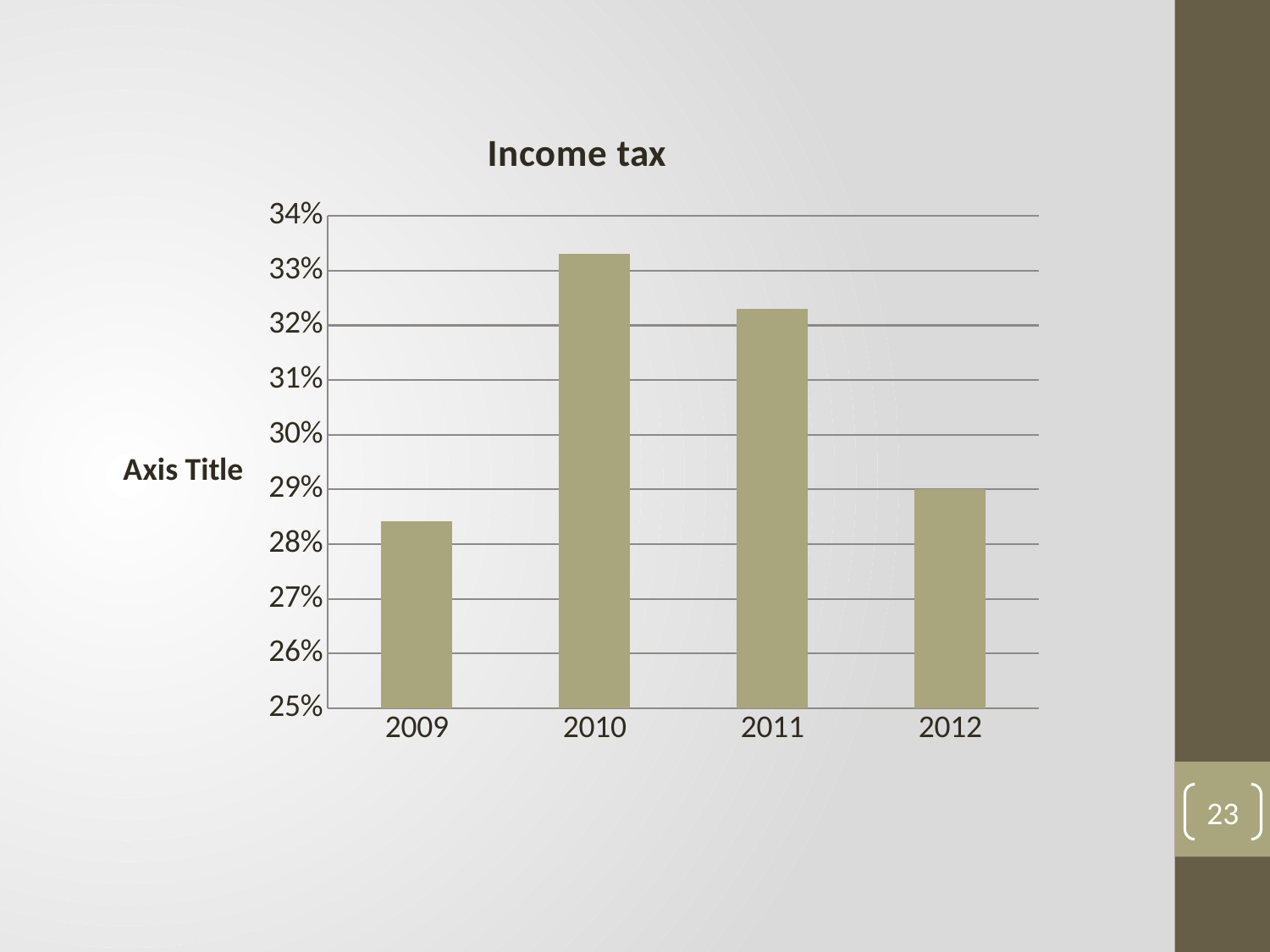
Which year has the highest income tax value? 2010 How many years are shown on the x axis of the chart? 4 Is the value for 2012 greater or less than 30%? less Which year has the larger value, 2009 or 2012? 2012 Do the values rise or fall from 2010 to 2012? fall Which year has the larger value, 2010 or 2011? 2010 Is the value for 2009 greater or less than 29%? less Is the value for 2011 greater or less than 32%? greater What is the title of the chart? Income tax What kind of chart is shown on the slide? bar chart Which year has the lowest income tax value? 2009